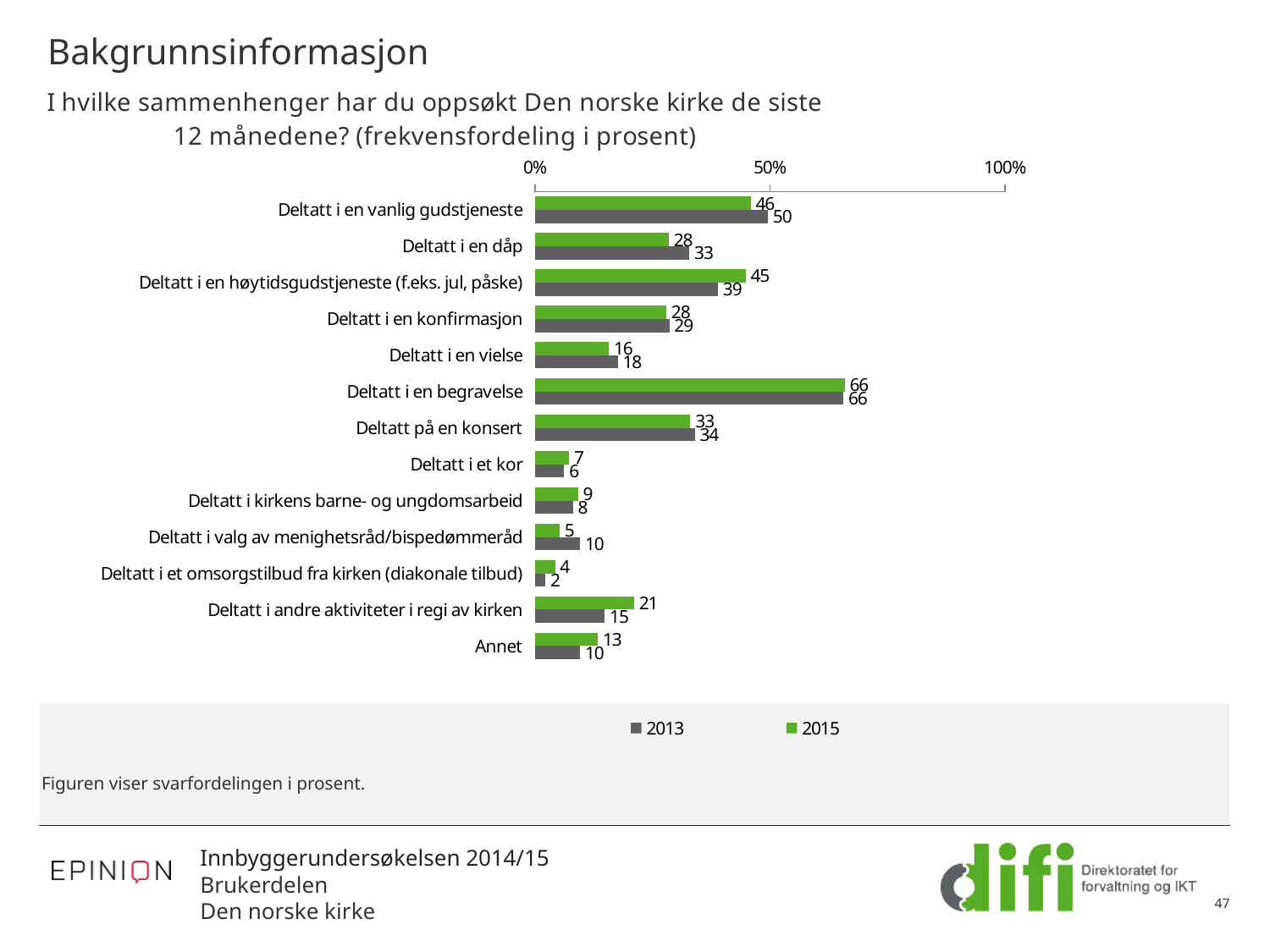
How many series does the legend list? 2 Which category has the lowest value for 2013? Deltatt i et omsorgstilbud fra kirken (diakonale tilbud) What is the 2015 value for "Deltatt i en vanlig gudstjeneste"? 46 How many categories are shown in the chart? 13 What is the 2013 value for "Deltatt i valg av menighetsråd/bispedømmeråd"? 10 Which is larger for "Deltatt i en dåp": the 2013 value or the 2015 value? 2013 What is the difference between the 2013 and 2015 values for "Deltatt i andre aktiviteter i regi av kirken"? 6 Which colour represents the 2015 series in the chart? Green What kind of chart is shown on the slide? Bar chart Which category has the highest value for 2015? Deltatt i en begravelse What is the 2013 value for "Deltatt i en høytidsgudstjeneste (f.eks. jul, påske)"? 39